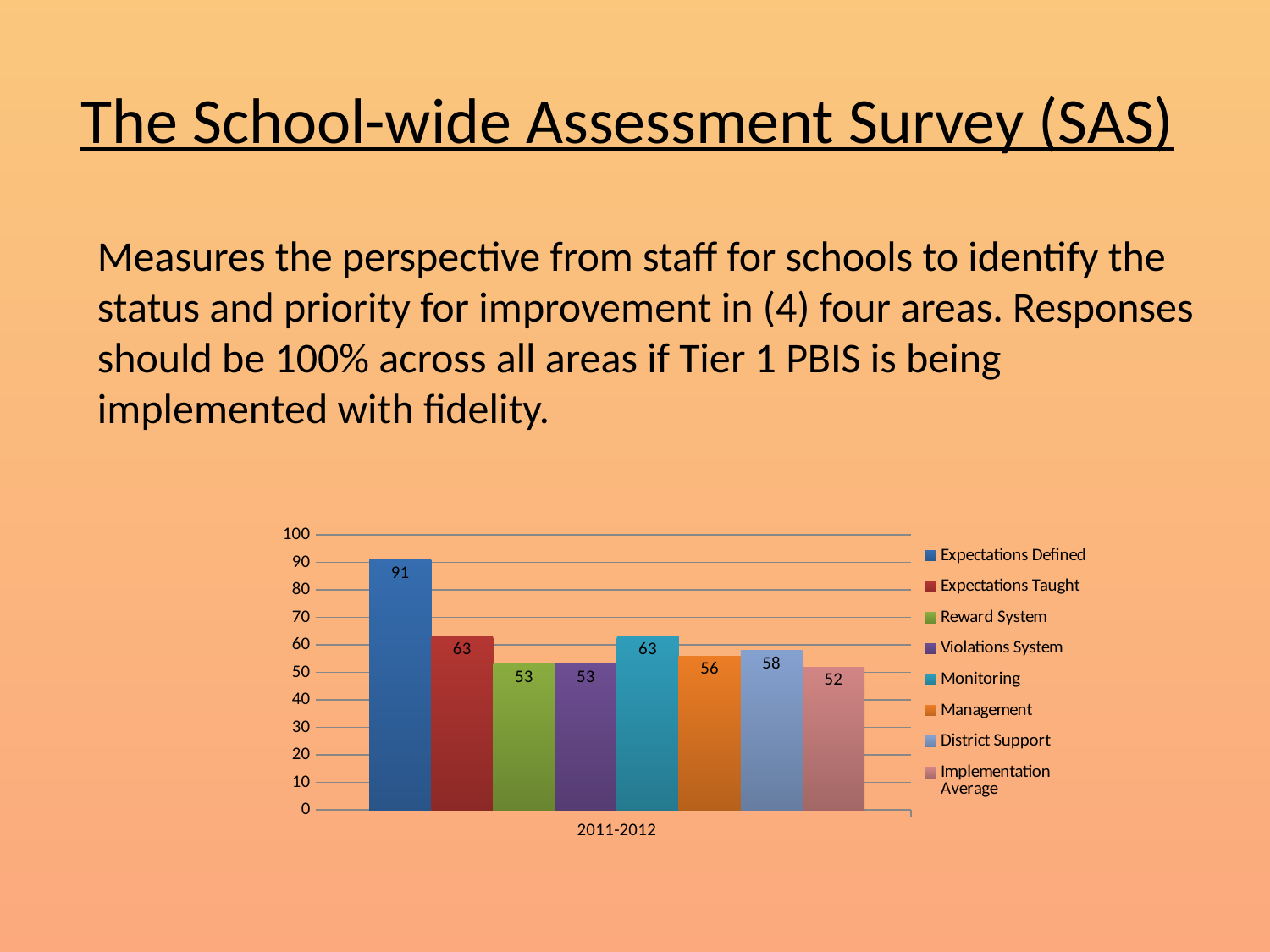
What is the value for Monitoring? 63 What is the category label shown on the x axis? 2011-2012 What is the value for District Support? 58 Which is larger, Management or Reward System? Management Which series has the lowest value? Implementation Average What kind of chart is shown on the slide? Bar chart What is the value for Implementation Average? 52 What is the value for Expectations Defined? 91 Which series has the highest value? Expectations Defined How many series does the legend list? 8 What is the difference between District Support and Management? 2 What is the difference between Expectations Defined and Expectations Taught? 28